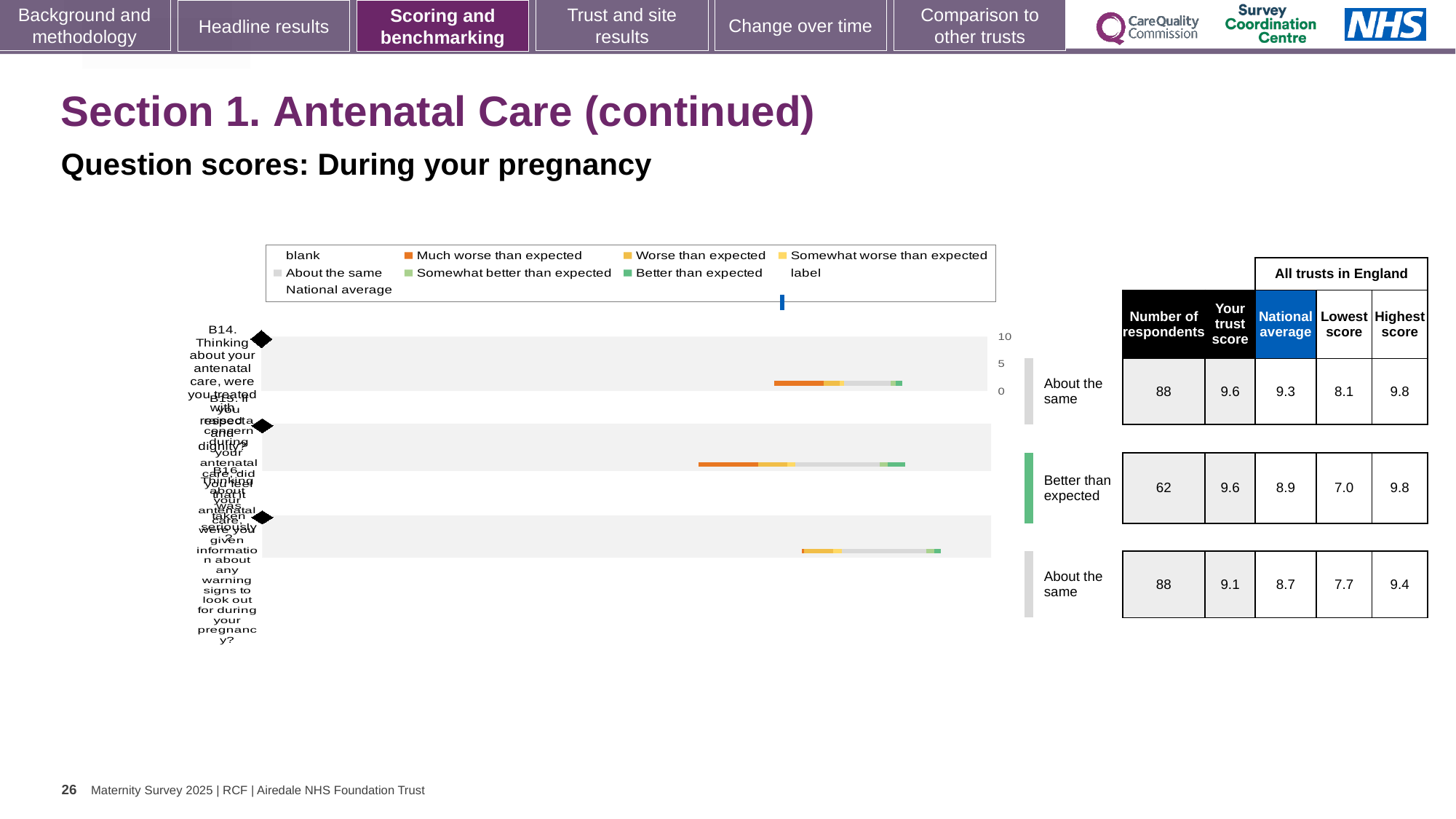
In the table, which row has the lowest 'Lowest score' value? Better than expected (7.0) In the table, what is the number of respondents for the third row (About the same)? 88 Which colour represents 'Much worse than expected' in the chart legend? orange How many question bars are plotted in the chart? 3 In the table, what is the national average for the second row (Better than expected)? 8.9 In the table, what is the trust score for the first row (B14, About the same)? 9.6 In the table, what is the difference between the trust score and the national average for the second row (Better than expected)? 0.7 What is the highest value shown on the chart's axis? 10 What is the benchmark rating shown next to the first bar (B14)? About the same What is the benchmark rating shown next to the second bar (B15)? Better than expected How many entries does the chart legend list? 9 What kind of chart is shown on the slide? bar chart